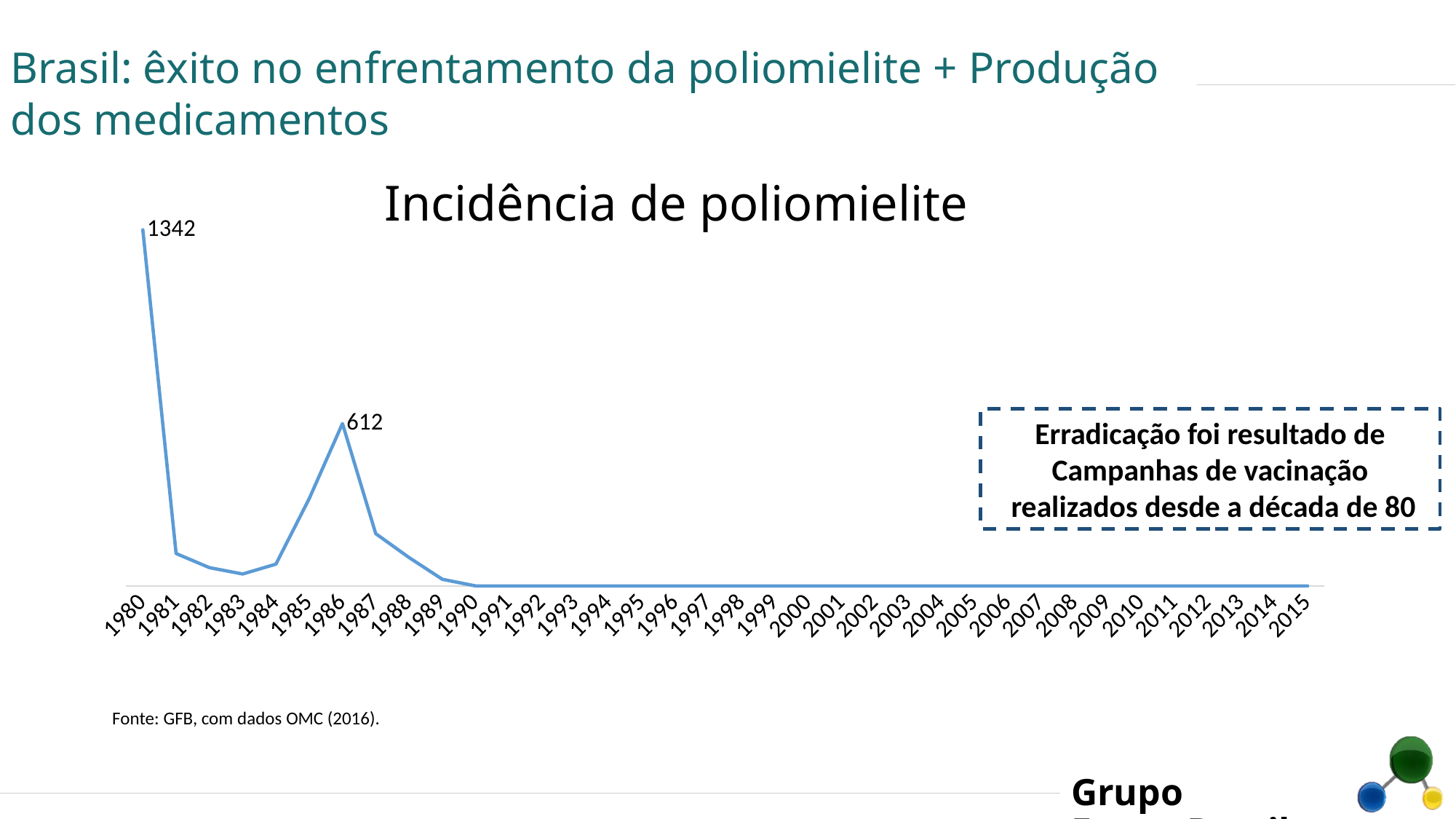
What is the value for 1980 in the Incidência de poliomielite chart? 1342 Do the values in the Incidência de poliomielite chart generally rise or fall from 1980 to 2015? fall What is the difference between the values for 1980 and 1986 in the Incidência de poliomielite chart? 730 Which year has the larger value, 1986 or 1987? 1986 What kind of chart is shown on the slide? line chart What is the last year shown on the x axis of the chart? 2015 What is the title of the chart on the slide? Incidência de poliomielite Which year has the larger value, 1980 or 1986? 1980 Which year has the highest value in the Incidência de poliomielite chart? 1980 What is the value for 1986 in the Incidência de poliomielite chart? 612 How many years are shown on the x axis of the Incidência de poliomielite chart? 36 Which year has the larger value, 1981 or 1986? 1986